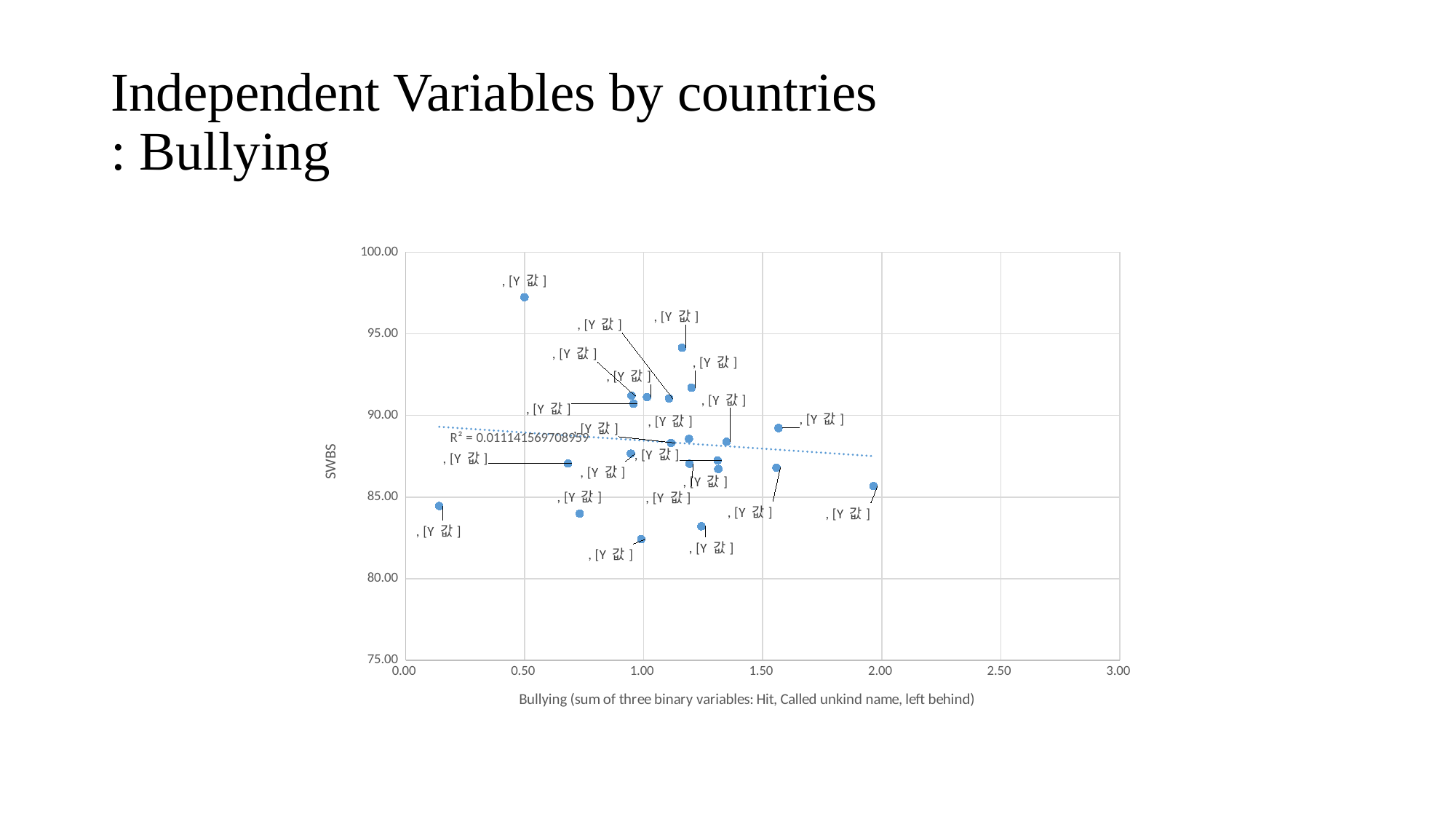
Is the SWBS value of the lowest point on the chart greater or less than 80.00? greater Is the SWBS value of the highest point on the chart greater or less than 100.00? less What kind of chart is shown on the slide? scatter chart Does the dotted trendline rise or fall as the Bullying value increases along the x axis? fall Is the SWBS value of the lowest point on the chart greater or less than 85.00? less What is the title of the x axis? Bullying (sum of three binary variables: Hit, Called unkind name, left behind)